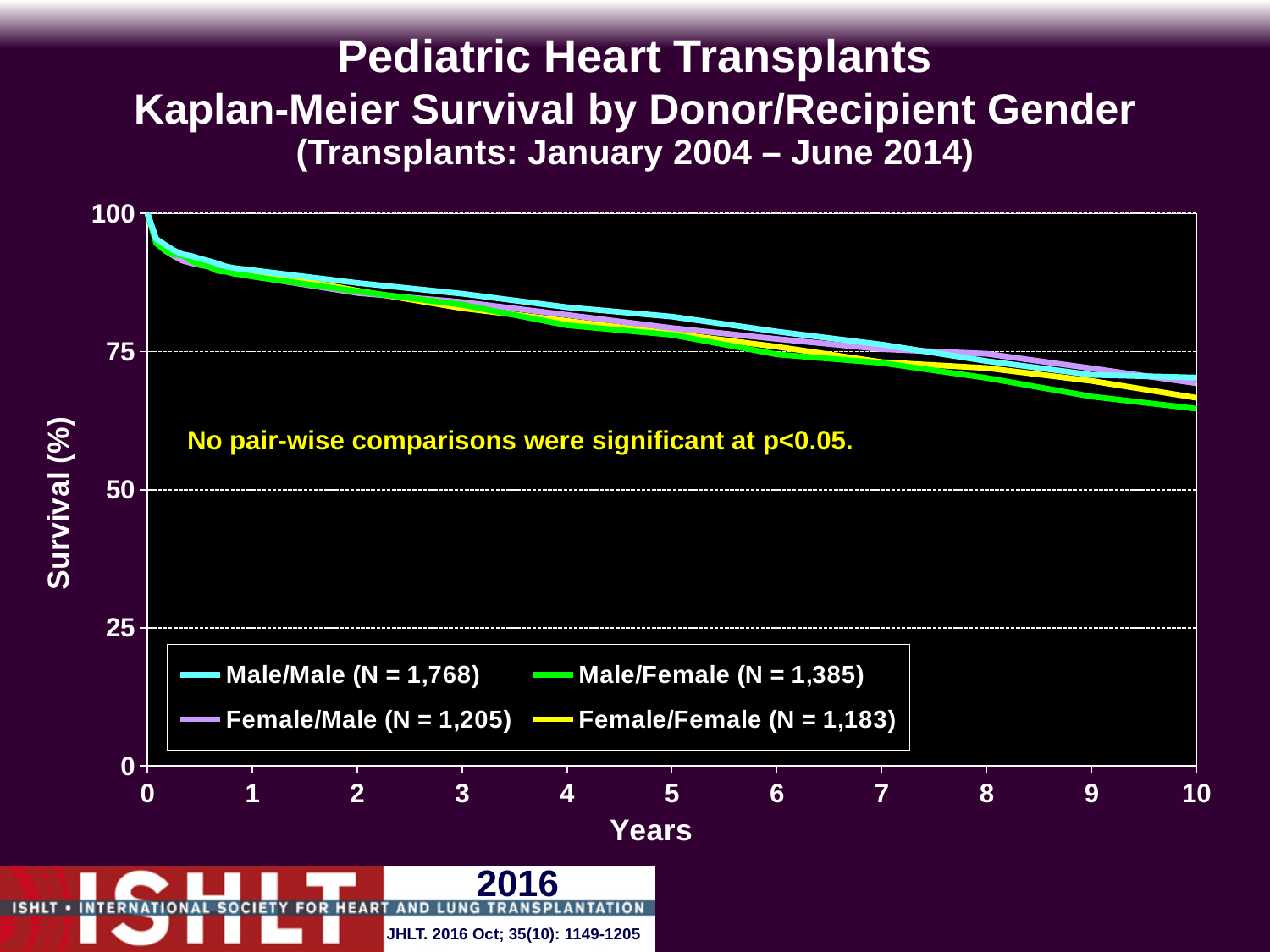
Is the survival value for Male/Male at 10 years greater or less than 50? greater What is the N for the Male/Male group in the legend? 1,768 What is the highest value shown on the Years axis? 10 What kind of chart is shown on the slide? line chart Is the survival value for Female/Male at 10 years greater or less than 75? less What is the N for the Female/Female group in the legend? 1,183 Is the survival value for Male/Female at 10 years greater or less than 75? less How many series does the legend list? 4 Do the survival curves rise or fall as the years increase? fall At 10 years, which has higher survival: Male/Male or Male/Female? Male/Male